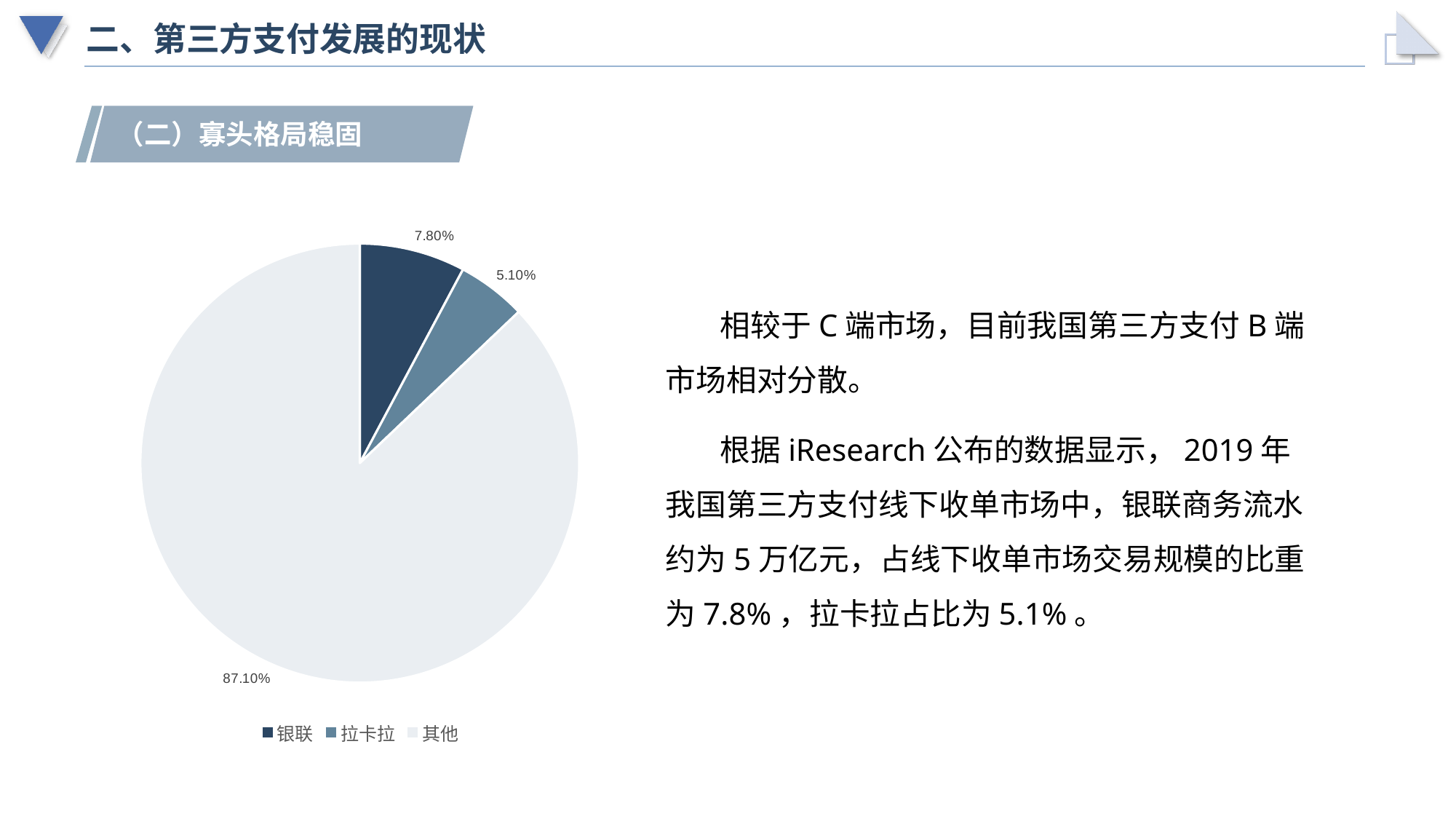
Which is larger, the slice for 银联 or the slice for 拉卡拉? 银联 How many entries does the legend list? 3 What kind of chart is shown on the slide? pie chart What share of the pie does 其他 take? 87.10% What is the value for 其他 in the pie chart? 87.10% Which legend entry is shown in the darkest blue colour? 银联 How many slices does the pie chart have? 3 Which category has the smallest slice in the pie chart? 拉卡拉 What is the value for 拉卡拉 in the pie chart? 5.10% Which category has the largest slice in the pie chart? 其他 What is the value for 银联 in the pie chart? 7.80% What is the difference between the values for 银联 and 拉卡拉? 2.70%